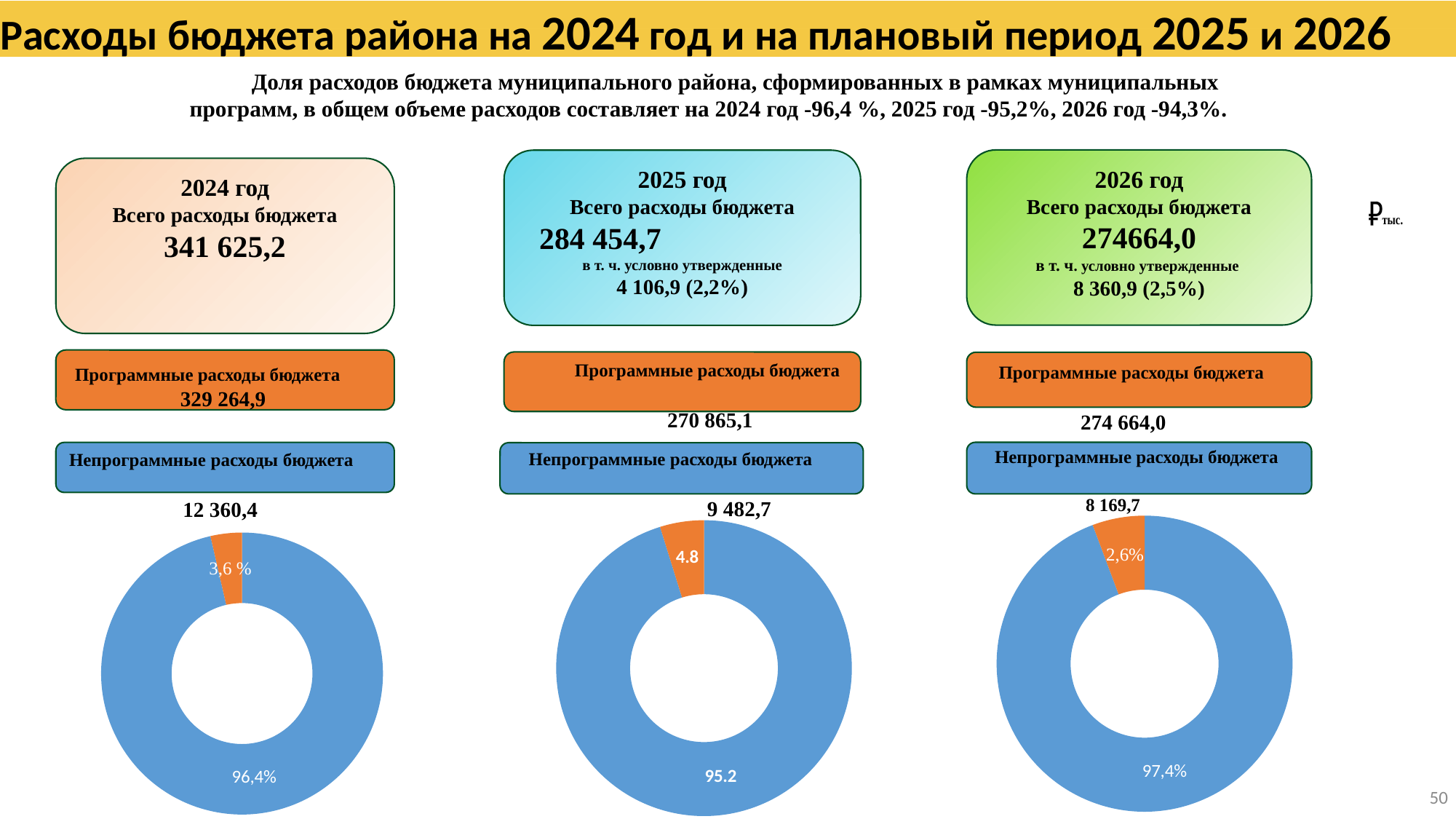
In the right donut chart (2026 год), what share is shown for the small orange slice? 2,6% In the middle donut chart (2025 год), what value is labelled on the large blue slice? 95.2 In the left donut chart (2024 год), what share is shown for the large blue slice? 96,4% In the left donut chart (2024 год), which slice is larger, the blue one or the orange one? the blue one What kind of chart is used for each of the three years on the slide? donut (pie) chart How many donut charts are shown on the slide? 3 How many slices does the left donut chart (2024 год) have? 2